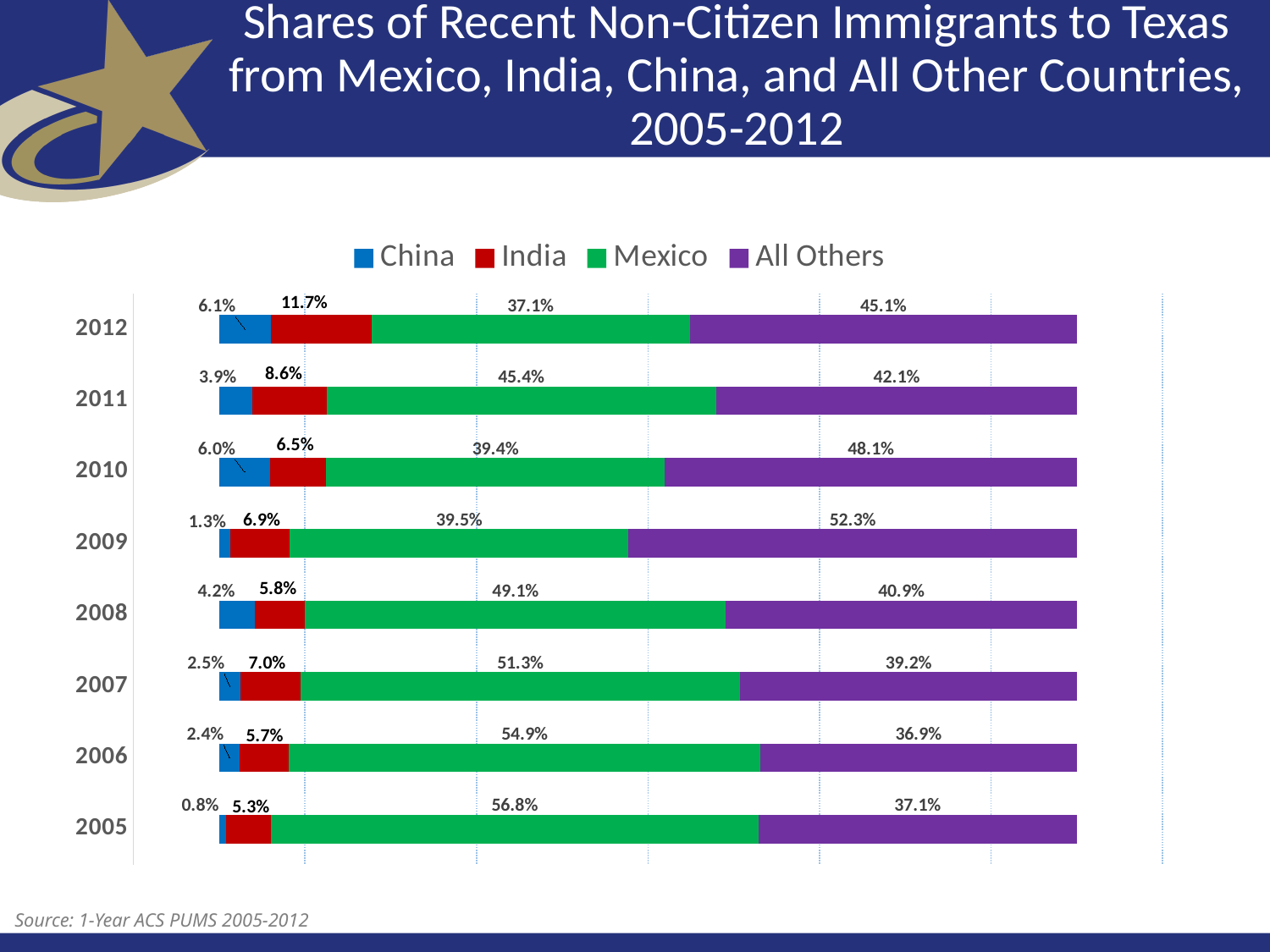
In 2008, which is larger: the Mexico share or the All Others share? Mexico What is the India share in 2012? 11.7% In which year is the China share the lowest? 2005 In which year is the All Others share the highest? 2009 What is the China share in 2009? 1.3% By how many percentage points did the Mexico share fall from 2005 to 2012? 19.7 percentage points In which year is the Mexico share the highest? 2005 How many years are shown on the chart? 8 What share of recent non-citizen immigrants to Texas came from Mexico in 2005? 56.8% What kind of chart is shown on the slide? Stacked bar chart How many series does the legend list? 4 What is the All Others share in 2010? 48.1%